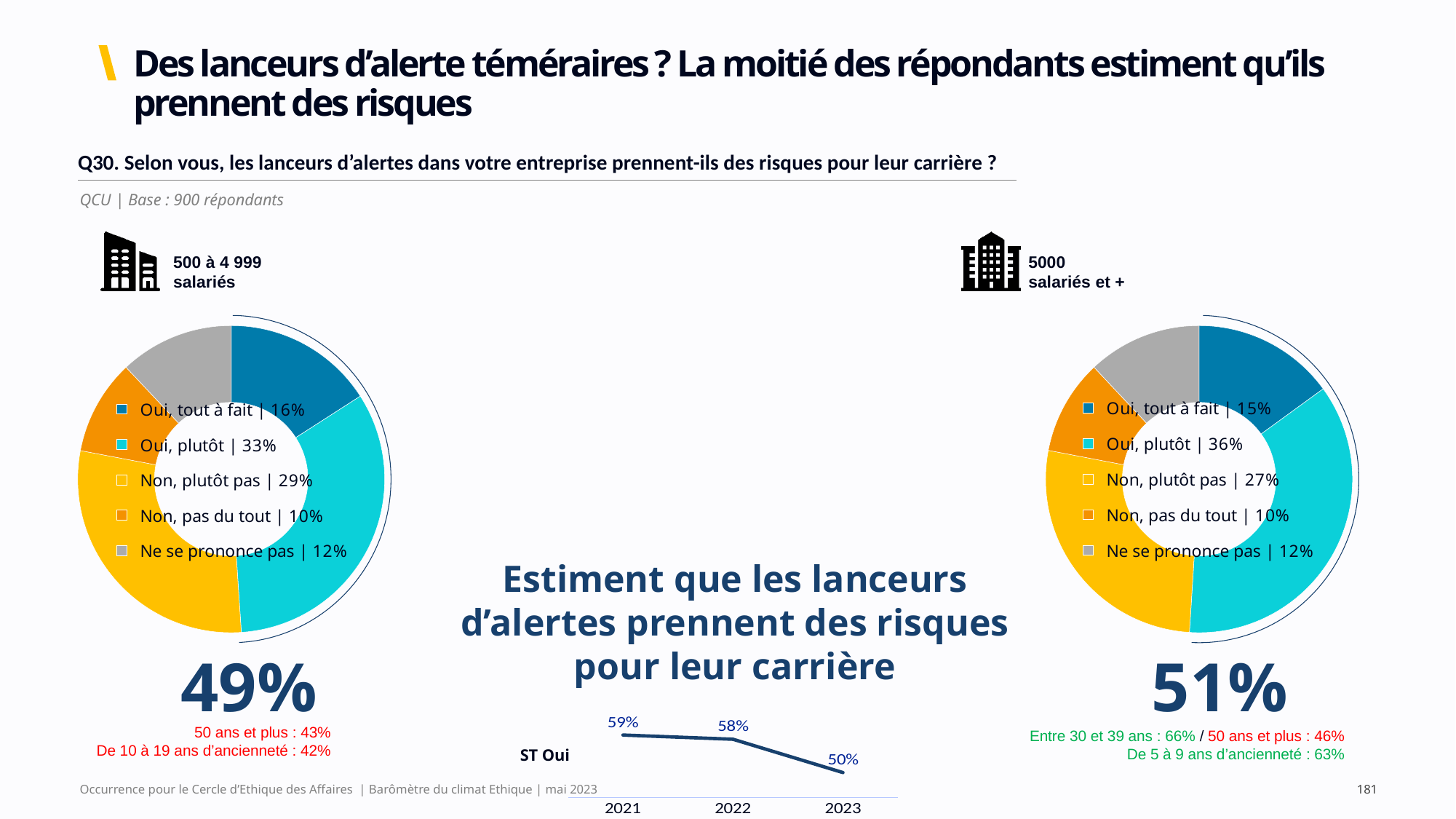
How many categories does the legend of the '5000 salariés et +' donut chart list? 5 Which is larger: 'Oui, tout à fait' in the '500 à 4 999 salariés' donut or 'Oui, tout à fait' in the '5000 salariés et +' donut? 500 à 4 999 salariés (16%) In the donut chart for '5000 salariés et +', what is the value for 'Non, plutôt pas'? 27% What is the combined share of 'Oui, tout à fait' and 'Oui, plutôt' in the '5000 salariés et +' donut chart? 51% What kind of chart is the 'ST Oui' chart at the bottom centre of the slide? Line chart In the donut chart for '5000 salariés et +', which category has the smallest share? Non, pas du tout In the donut chart for '500 à 4 999 salariés', what is the difference between 'Oui, plutôt' and 'Non, plutôt pas'? 4 points In the 'ST Oui' line chart, what is the difference between the 2021 and 2023 values? 9 points In the donut chart for '500 à 4 999 salariés', which category has the largest share? Oui, plutôt In the donut chart for '500 à 4 999 salariés', what is the value for 'Oui, plutôt'? 33% In the 'ST Oui' line chart, do the values rise or fall from 2021 to 2023? Fall In the 'ST Oui' line chart, what is the value for 2022? 58%